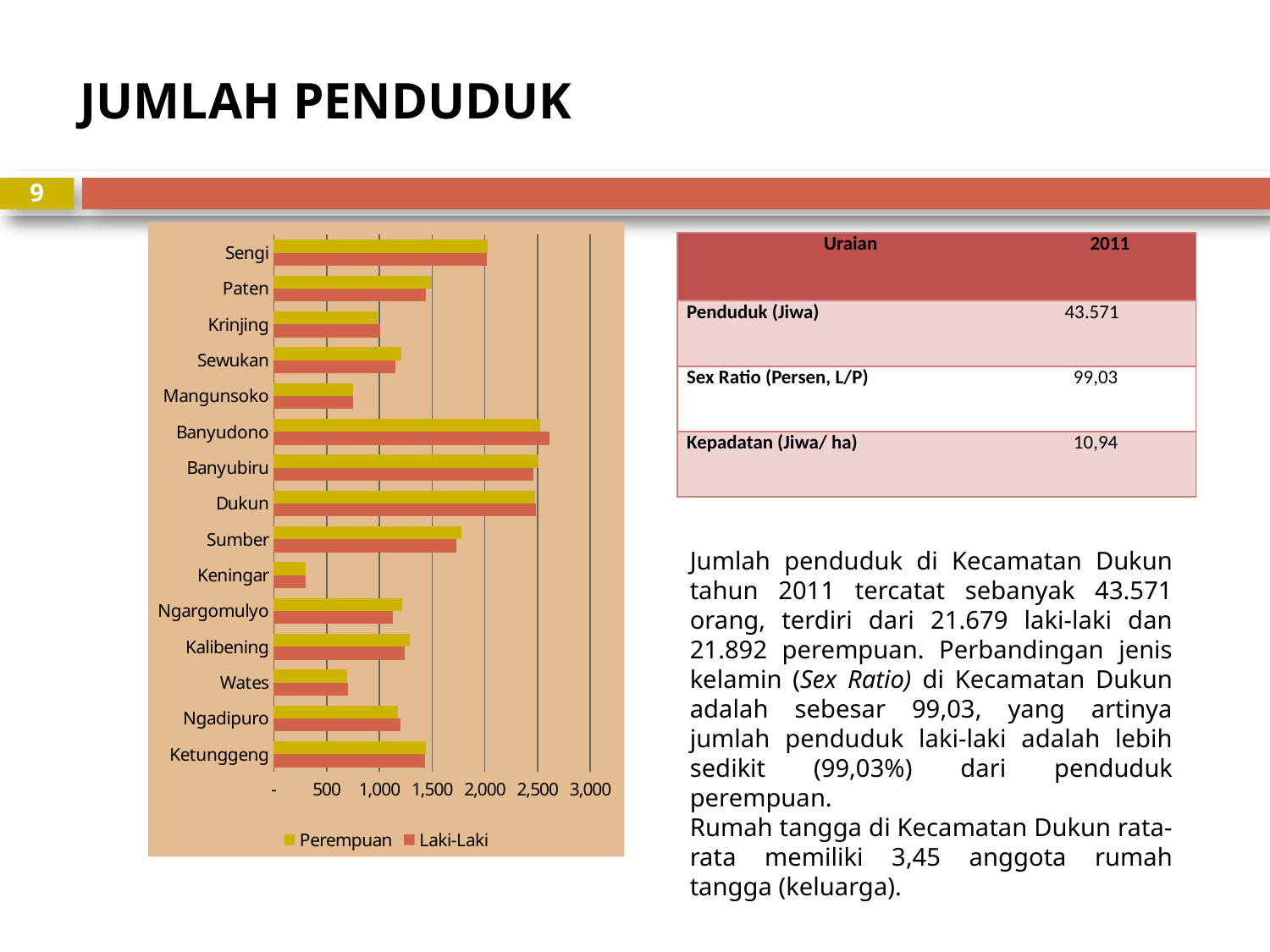
What are the two series named in the chart legend? Perempuan and Laki-Laki Is the Laki-Laki value for Banyudono greater or less than 2,500? greater Which category has the lowest Perempuan value? Keningar How many series does the chart legend list? 2 Is the Perempuan value for Keningar greater or less than 500? less Is the Perempuan value for Sumber greater or less than 1,500? greater Which is larger, the Perempuan value for Sengi or for Sumber? Sengi How many categories (villages) are plotted on the chart? 15 What kind of chart is shown on the slide? bar chart Which is larger, the Perempuan value for Wates or for Keningar? Wates Which category has the highest Laki-Laki value? Banyudono